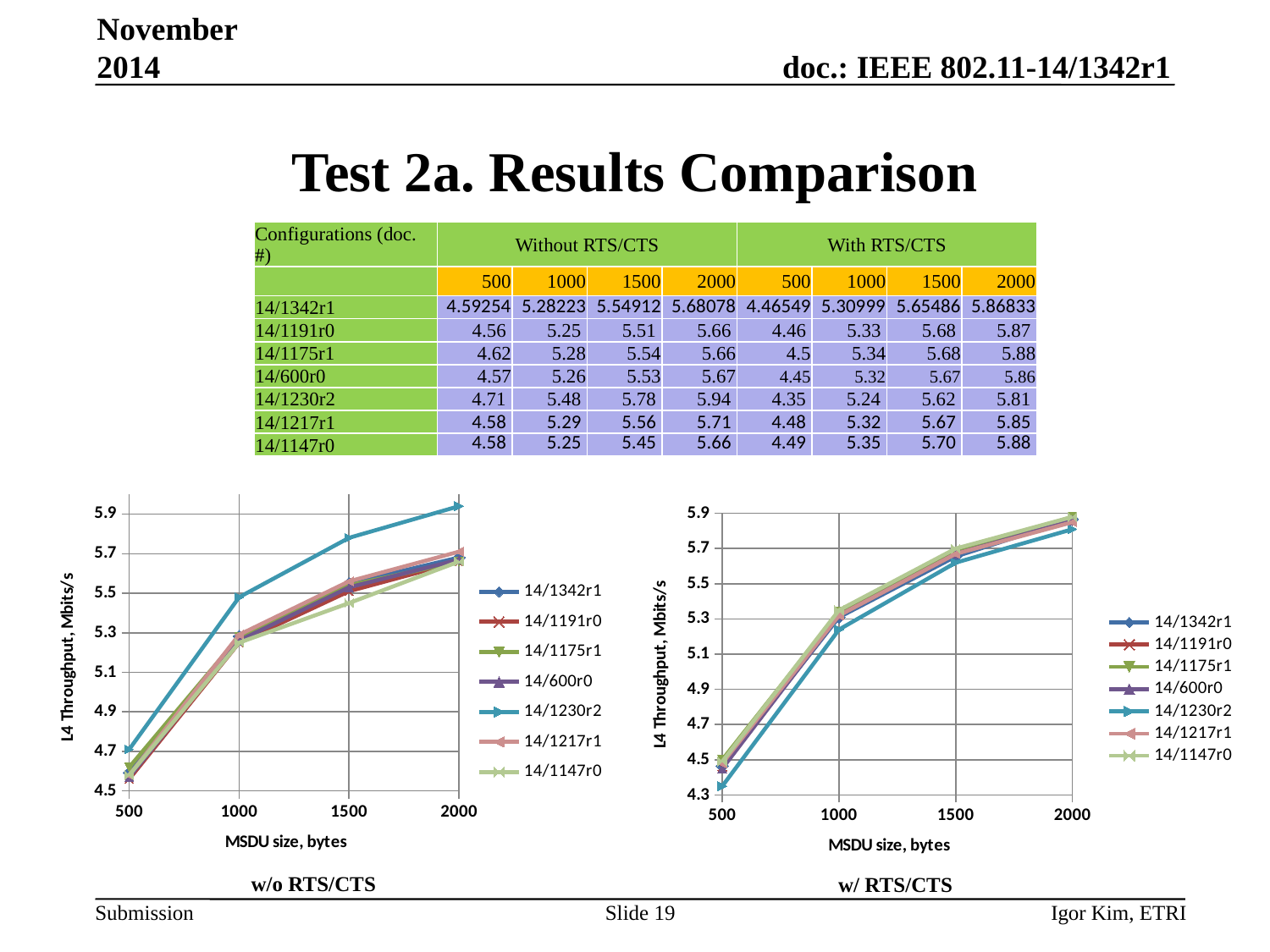
In the w/ RTS/CTS chart, which series has the lowest throughput at MSDU size 500? 14/1230r2 In the w/ RTS/CTS chart, is the value for 14/1230r2 at MSDU size 500 greater or less than 4.5? less How many MSDU size points are plotted along the x axis of the w/o RTS/CTS chart? 4 What is the x-axis title of the w/ RTS/CTS chart? MSDU size, bytes In the w/o RTS/CTS chart, which series has the highest throughput at MSDU size 2000? 14/1230r2 Using the table values, what is the difference between 14/1230r2 and 14/1191r0 at MSDU size 2000 without RTS/CTS? 0.28 In the w/o RTS/CTS chart, does the throughput of 14/1342r1 rise or fall as MSDU size increases from 500 to 2000? rise In the w/ RTS/CTS chart, which is larger at MSDU size 1000: 14/1230r2 or 14/1147r0? 14/1147r0 In the w/o RTS/CTS chart, is the value for 14/1230r2 at MSDU size 1500 greater or less than 5.7? greater How many series does the legend of the w/ RTS/CTS chart list? 7 What type of chart is the w/o RTS/CTS chart on the left? line chart According to the table, what is the throughput of 14/1230r2 at MSDU size 2000 without RTS/CTS? 5.94